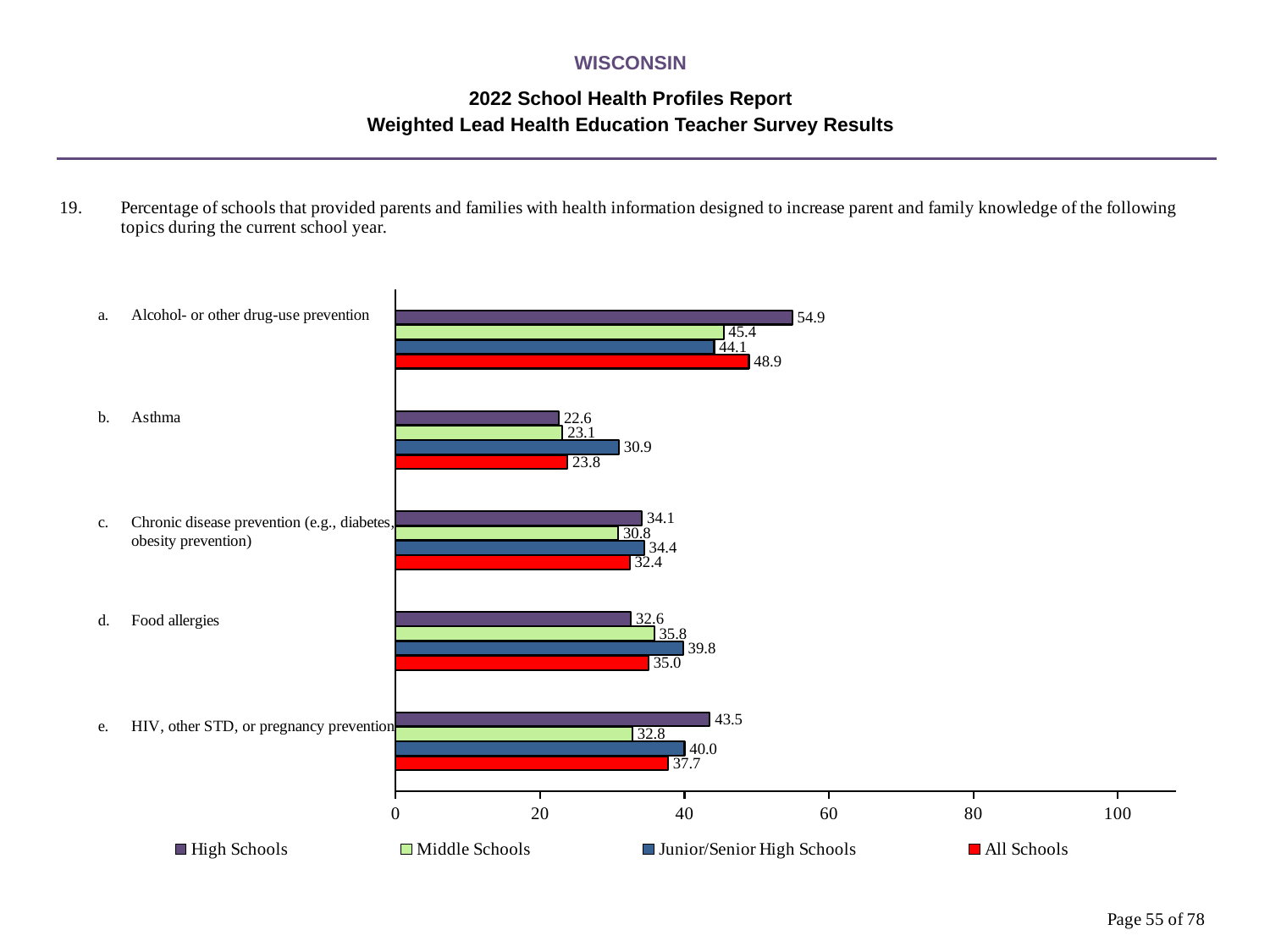
What is the value for All Schools for Food allergies? 35.0 Which topic has the highest value for All Schools? Alcohol- or other drug-use prevention What is the value for Junior/Senior High Schools for Asthma? 30.9 Which is larger for Food allergies: the Junior/Senior High Schools value or the High Schools value? Junior/Senior High Schools Which topic has the lowest value for High Schools? Asthma How many topics are shown on the chart? 5 Is the All Schools value for Alcohol- or other drug-use prevention greater or less than 40? greater What kind of chart is shown on the slide? Bar chart What is the value for High Schools for Alcohol- or other drug-use prevention? 54.9 What is the value for Middle Schools for HIV, other STD, or pregnancy prevention? 32.8 What is the difference between the High Schools and Middle Schools values for HIV, other STD, or pregnancy prevention? 10.7 How many series does the legend list? 4